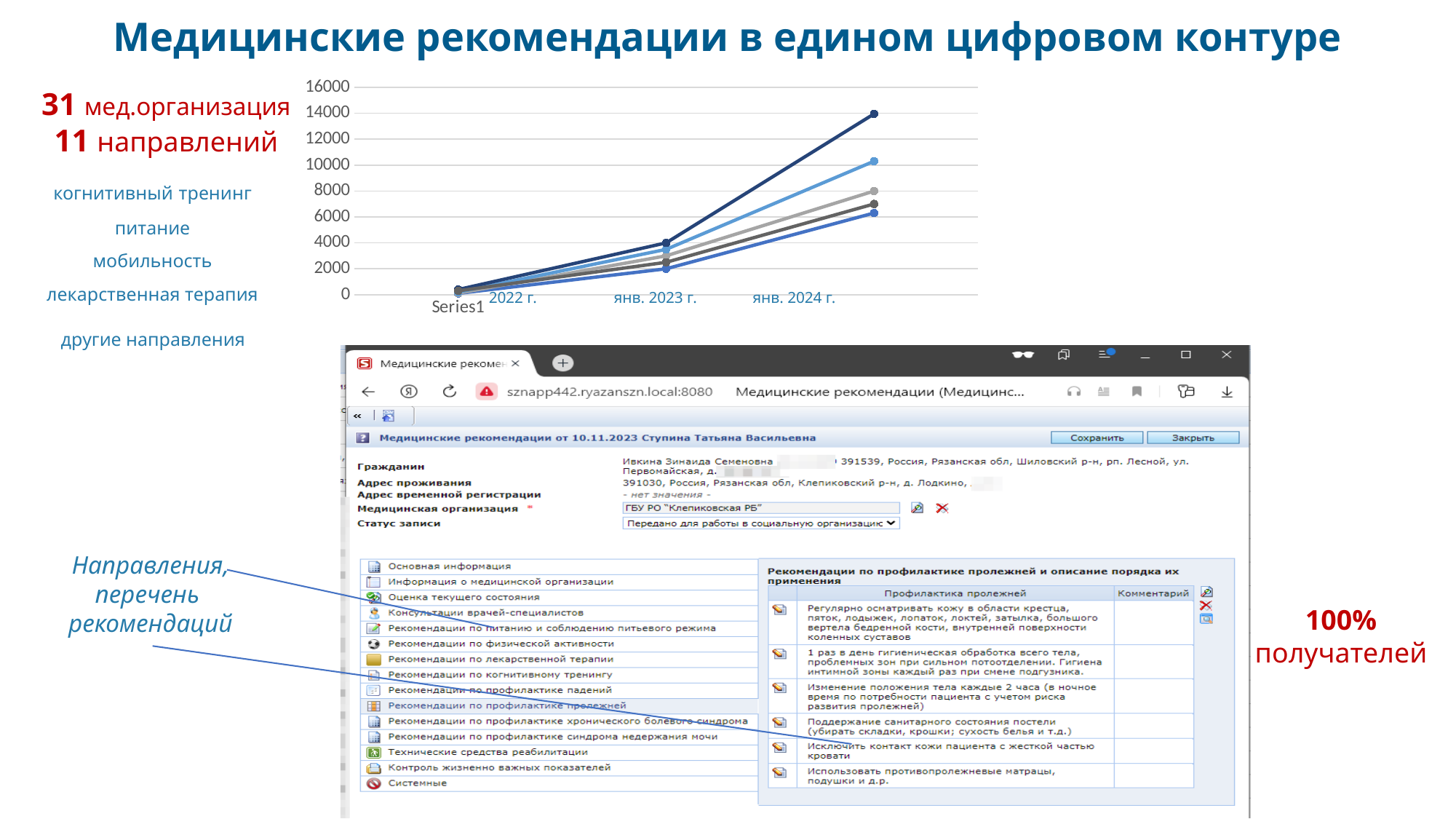
What is the label of the first category on the x axis of the line chart? Series1 Do the values on the line chart rise or fall from 2022 г. to янв. 2024 г.? rise Is the value of the second-highest line at янв. 2024 г. greater or less than 12000? less At which x-axis category do the lines reach their highest values? янв. 2024 г. Is the value of the highest line at янв. 2024 г. greater or less than 12000? greater What is the maximum value shown on the y axis of the line chart? 16000 How many lines are plotted on the line chart? 5 Is the value of the highest line at 2022 г. greater or less than 2000? less How many categories are labelled along the x axis of the line chart? 4 What kind of chart is shown on the slide? line chart